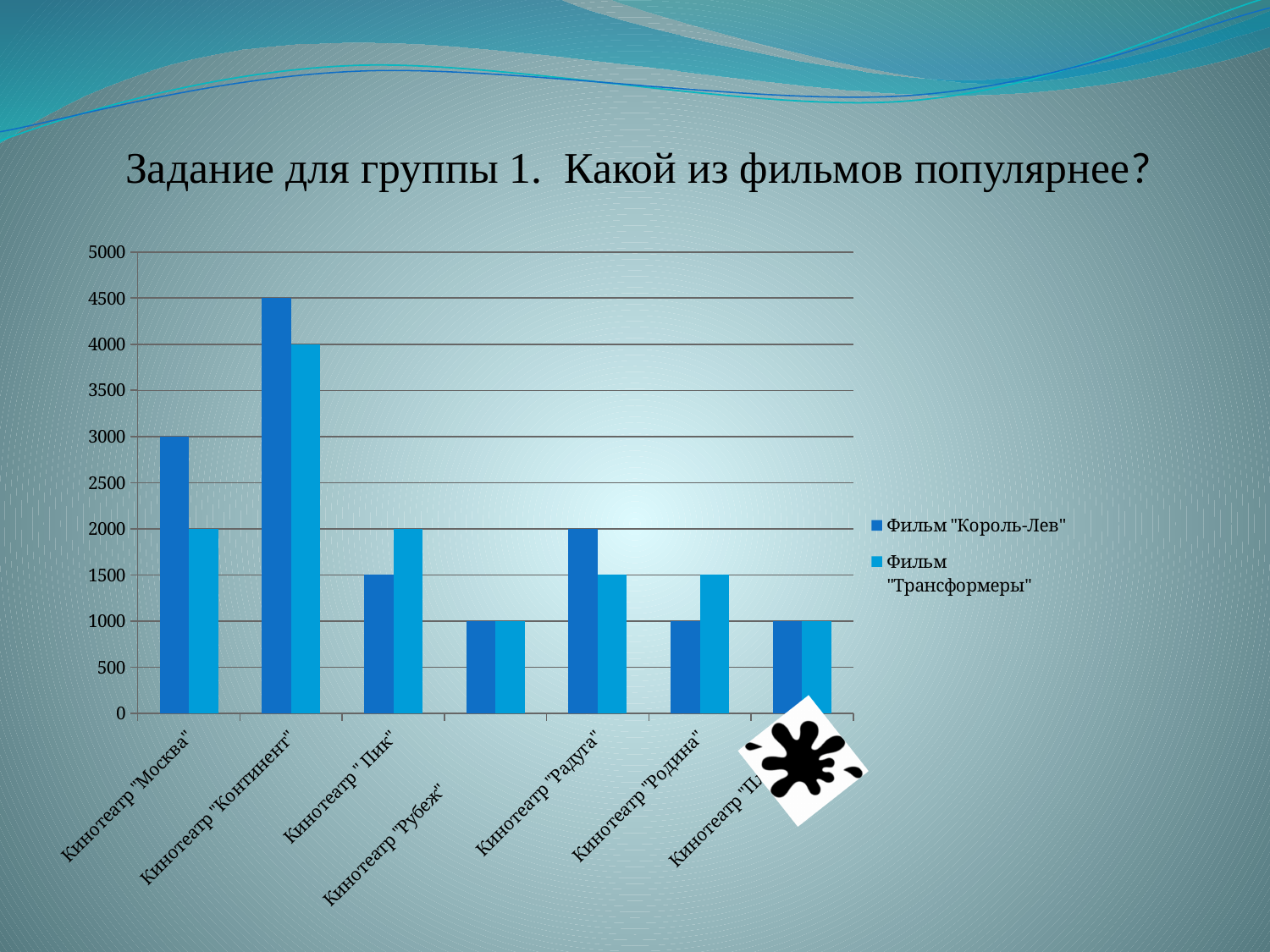
What is the title of the slide above the chart? Задание для группы 1. Какой из фильмов популярнее? Which cinema has the highest value for Фильм "Король-Лев"? Кинотеатр "Континент" What is the value for Фильм "Король-Лев" at Кинотеатр "Радуга"? 2000 Is the value for Фильм "Король-Лев" at Кинотеатр "Континент" greater or less than 4000? greater What is the value for Фильм "Король-Лев" at Кинотеатр "Москва"? 3000 What is the value for Фильм "Трансформеры" at Кинотеатр "Родина"? 1500 What is the value for Фильм "Трансформеры" at Кинотеатр "Континент"? 4000 How many series does the legend list? 2 What is the difference between Фильм "Король-Лев" and Фильм "Трансформеры" at Кинотеатр "Москва"? 1000 What type of chart is shown on the slide? Bar chart How many cinemas (categories) are plotted on the chart? 7 At Кинотеатр "Пик", which film has the larger value? Фильм "Трансформеры"